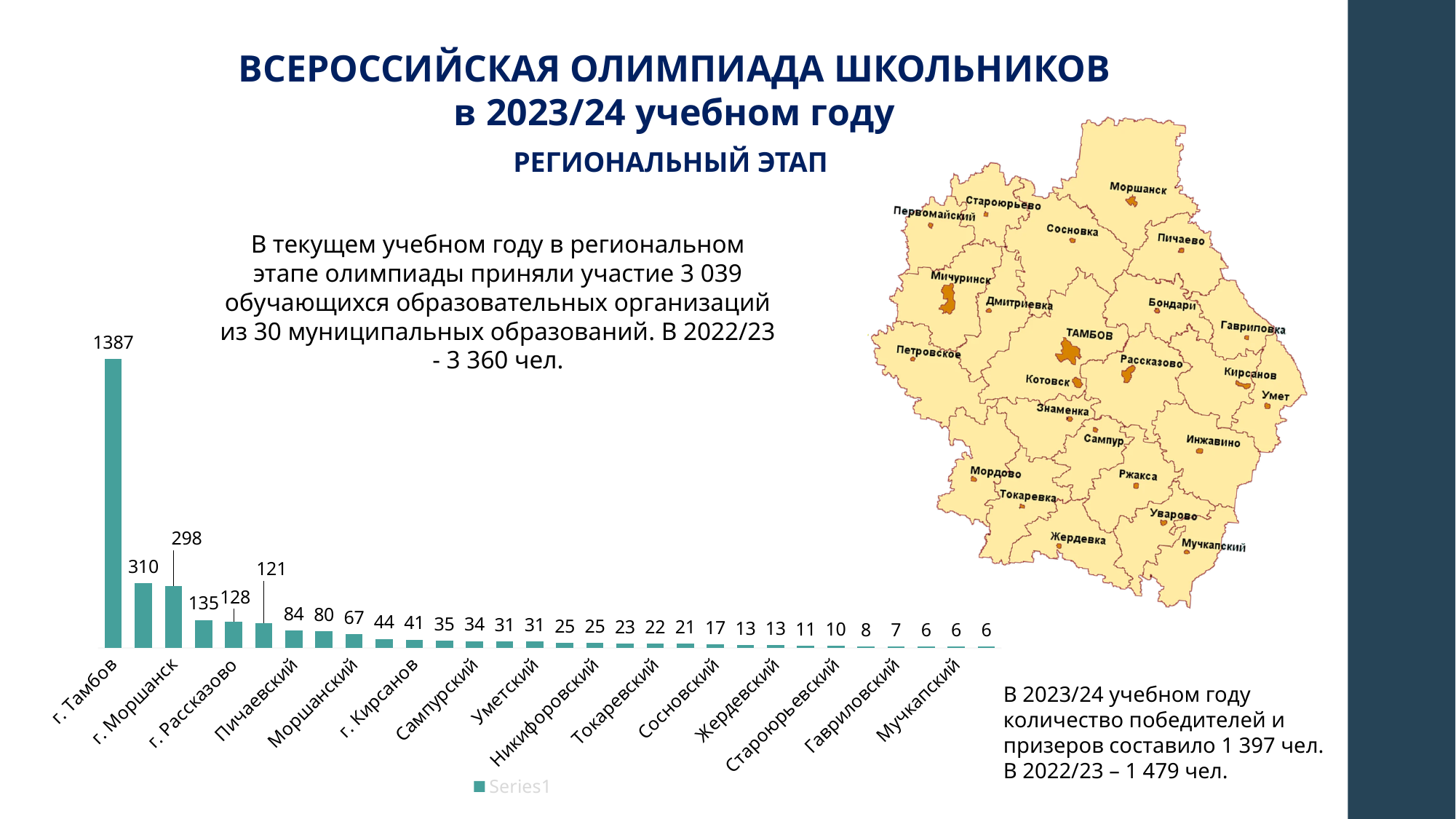
What is the lowest value shown on any bar in the chart? 6 What is the value for г. Тамбов in the bar chart? 1387 Which category has the highest value in the bar chart? г. Тамбов How many bars in the chart have the value 6? 3 What is the value of the tallest bar in the chart? 1387 What is the difference between the highest bar (1387) and the second-highest bar (310)? 1077 What kind of chart is shown on the slide? bar chart How many bars are plotted in the chart? 30 How many series does the chart legend list? 1 Do the bar values rise or fall from left to right along the x axis? fall What is the difference between the highest value (1387) and the lowest value (6) in the chart? 1381 What is the name of the series shown in the chart legend? Series1